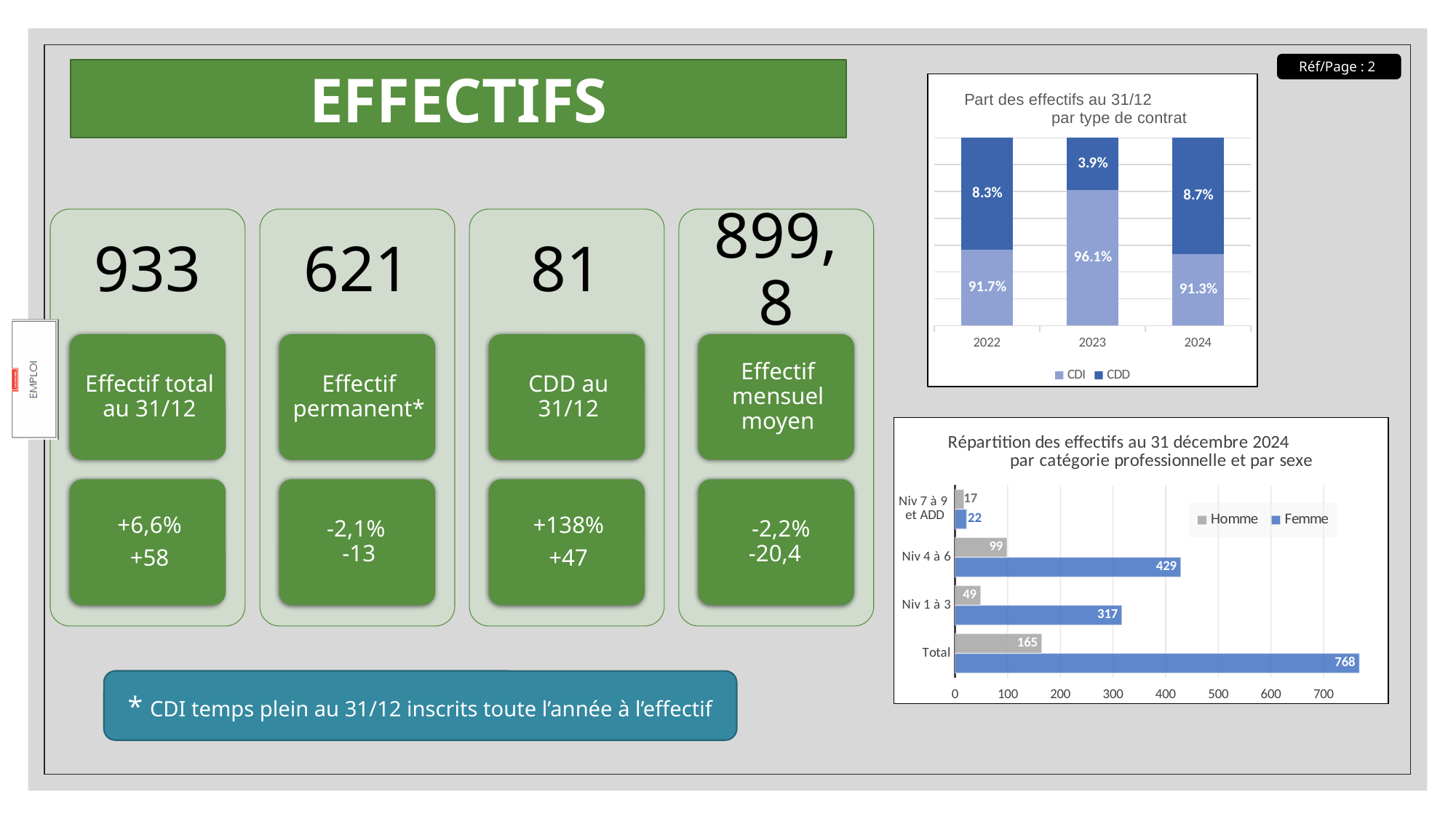
What kind of chart is 'Répartition des effectifs au 31 décembre 2024 par catégorie professionnelle et par sexe'? Bar chart In the chart 'Répartition des effectifs au 31 décembre 2024 par catégorie professionnelle et par sexe', what is the difference between the Femme and Homme values for Total? 603 In the chart 'Répartition des effectifs au 31 décembre 2024 par catégorie professionnelle et par sexe', what is the Femme value for Niv 4 à 6? 429 In the chart 'Part des effectifs au 31/12 par type de contrat', what is the difference between the CDD share in 2024 and in 2023? 4.8% In the chart 'Répartition des effectifs au 31 décembre 2024 par catégorie professionnelle et par sexe', how many categories are shown on the vertical axis? 4 In the chart 'Part des effectifs au 31/12 par type de contrat', what is the CDD share in 2024? 8.7% In the chart 'Part des effectifs au 31/12 par type de contrat', what is the CDI share in 2023? 96.1% In the chart 'Part des effectifs au 31/12 par type de contrat', how many series does the legend list? 2 In the chart 'Répartition des effectifs au 31 décembre 2024 par catégorie professionnelle et par sexe', which is larger for Niv 7 à 9 et ADD, Homme or Femme? Femme In the chart 'Part des effectifs au 31/12 par type de contrat', which year has the lowest CDD share? 2023 In the chart 'Répartition des effectifs au 31 décembre 2024 par catégorie professionnelle et par sexe', what is the Homme value for Niv 1 à 3? 49 In the chart 'Répartition des effectifs au 31 décembre 2024 par catégorie professionnelle et par sexe', which colour represents Homme? Grey